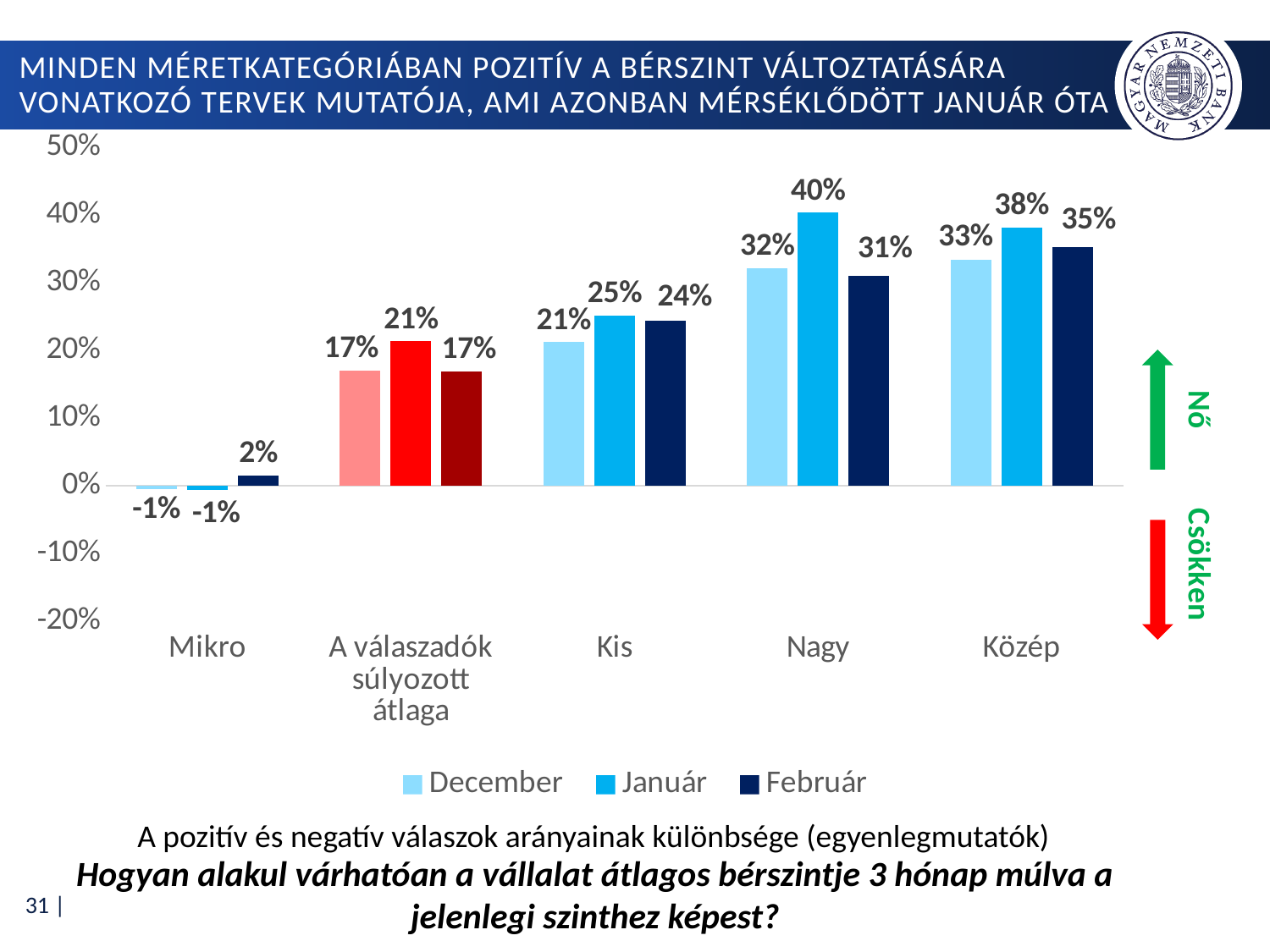
Which series is shown in the darkest blue colour according to the legend? Február What is the December value for Közép? 33% What kind of chart is shown on the slide? Bar chart What is the Február value for Mikro? 2% How many series does the legend list? 3 What is the Január value for Nagy? 40% What is the Január value for 'A válaszadók súlyozott átlaga'? 21% Which category has the highest Január value? Nagy What is the difference between the Január and Február values for Nagy? 9% Which is larger for Kis: the Január value or the December value? Január How many categories are shown on the x axis? 5 Which category has the lowest December value? Mikro